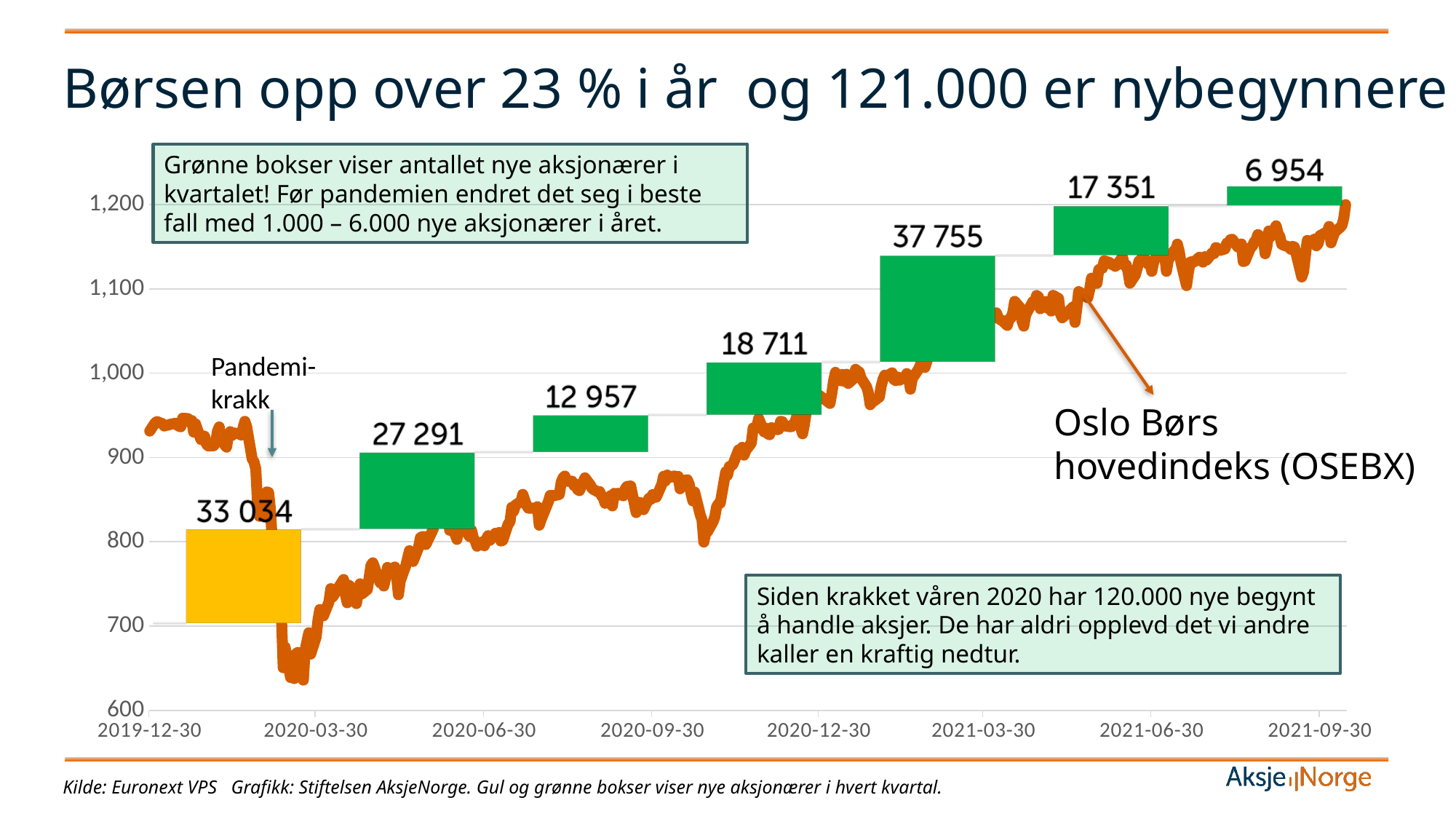
Which is larger, the box labelled 27 291 or the box labelled 12 957? 27 291 What is the difference between the box labelled 37 755 and the box labelled 18 711? 19 044 How many yellow and green boxes are shown on the chart? 7 Which box shows the highest number of new shareholders in a quarter? 37 755 Does the OSEBX line rise or fall from 2020-03-30 to 2021-09-30? Rises Which box shows the lowest number of new shareholders in a quarter? 6 954 What kind of chart is the orange OSEBX series drawn as? Line chart What is the difference between the box labelled 17 351 and the box labelled 6 954? 10 397 What does the orange line on the chart represent? Oslo Børs hovedindeks (OSEBX) What value is shown in the yellow box on the chart? 33 034 Is the lowest point of the OSEBX line, around March 2020, greater or less than 700? less What value is shown in the last green box, at the far right of the chart? 6 954